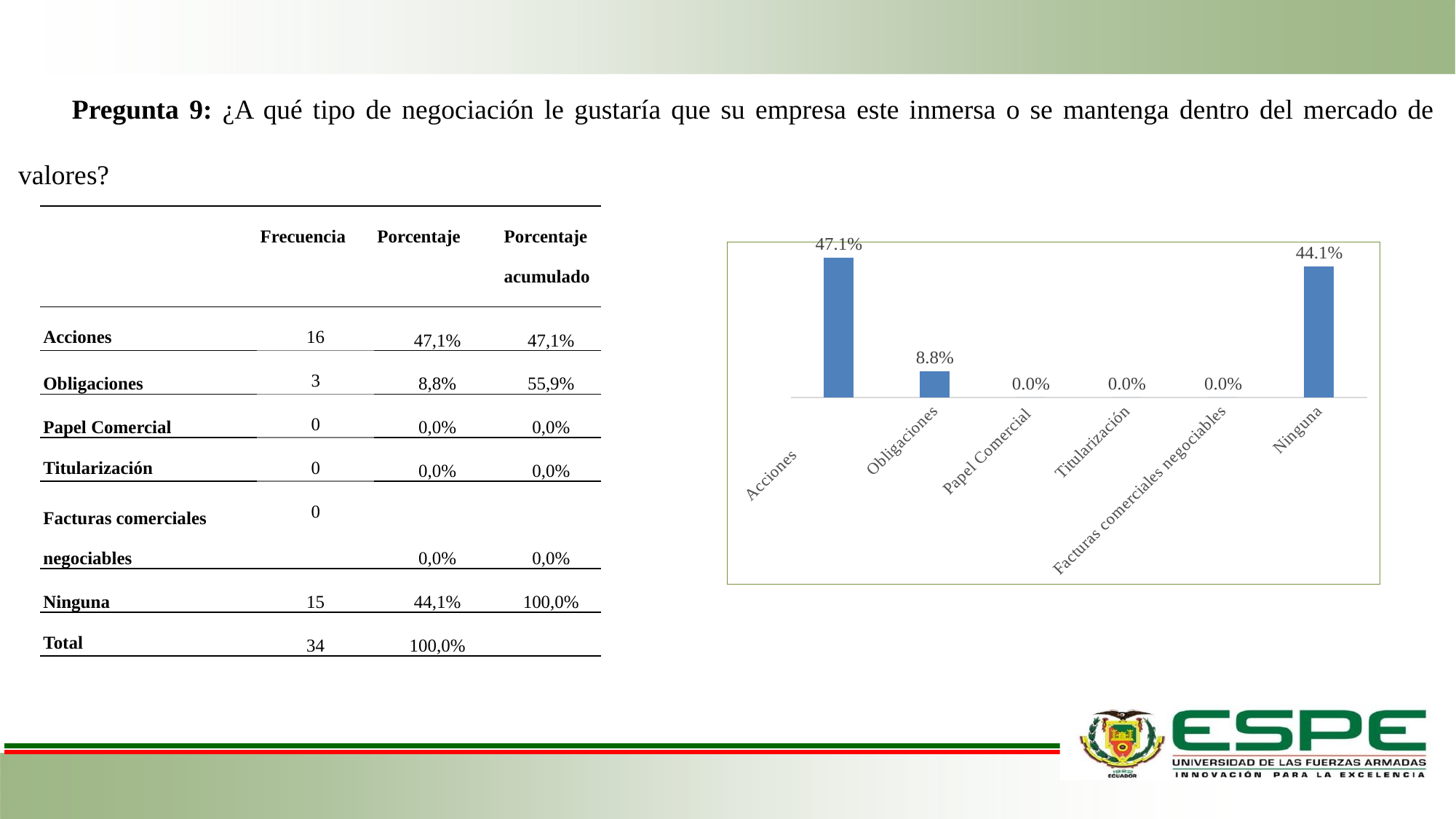
How many categories are shown on the x axis of the chart? 6 What is the value shown for Obligaciones in the chart? 8.8% Which is larger in the chart, the value for Obligaciones or the value for Ninguna? Ninguna What colour are the bars in the chart? Blue Which category has the highest value in the chart? Acciones What is the difference between the values for Acciones and Ninguna in the chart? 3.0% What kind of chart is shown on the slide? Bar chart What is the value shown for Titularización in the chart? 0.0% What is the value shown for Ninguna in the chart? 44.1% What is the difference between the values for Ninguna and Obligaciones in the chart? 35.3% How many categories in the chart have a value of 0.0%? 3 What is the value shown for Acciones in the chart? 47.1%